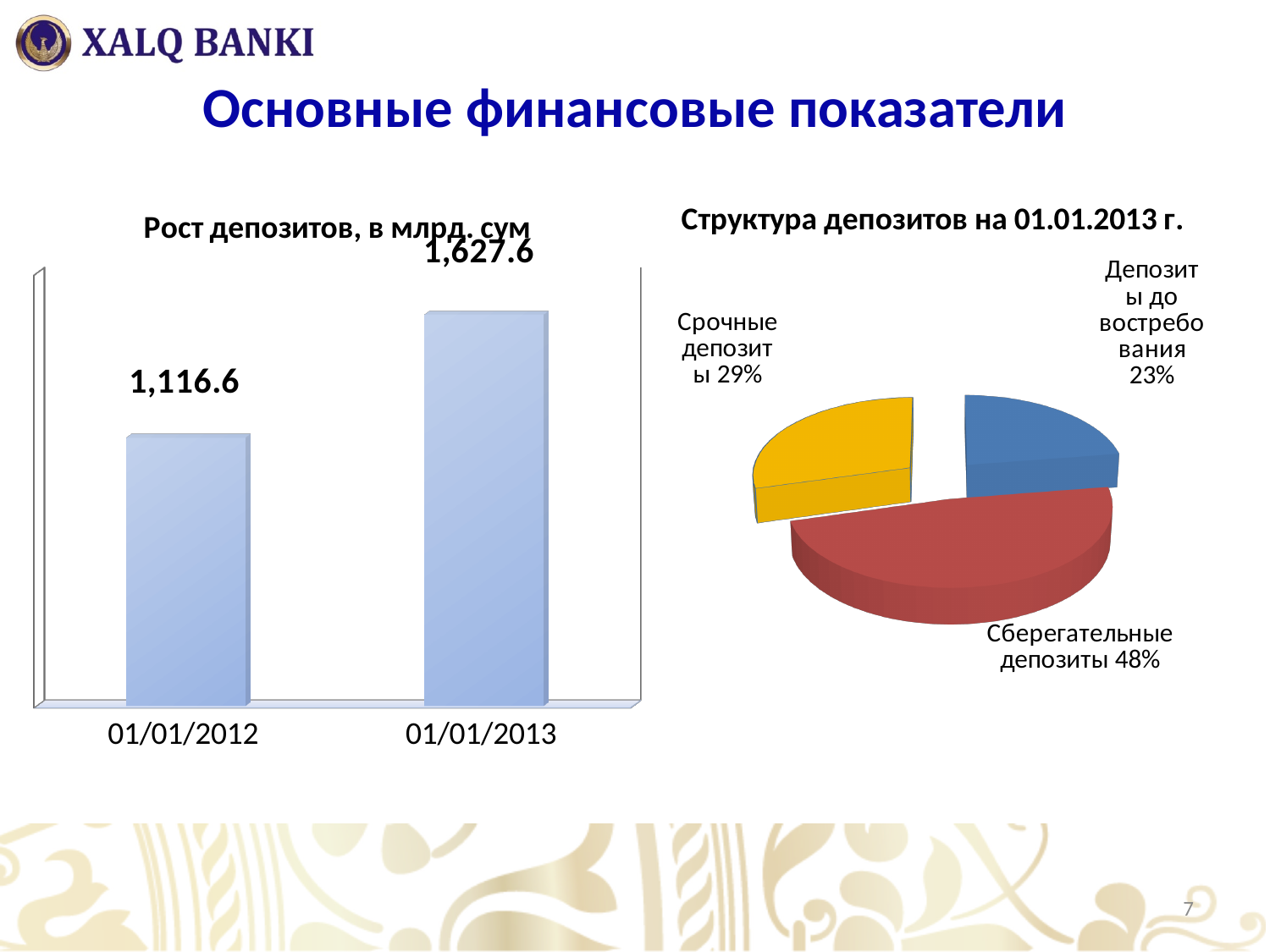
In the chart 'Рост депозитов, в млрд. сум', do the values rise or fall from 01/01/2012 to 01/01/2013? rise In the chart 'Структура депозитов на 01.01.2013 г.', which is larger: Срочные депозиты or Депозиты до востребования? Срочные депозиты In the chart 'Структура депозитов на 01.01.2013 г.', which category has the smallest share? Депозиты до востребования In the chart 'Структура депозитов на 01.01.2013 г.', what share do Срочные депозиты have? 29% What kind of chart is 'Рост депозитов, в млрд. сум'? bar chart How many bars are shown in the chart 'Рост депозитов, в млрд. сум'? 2 In the chart 'Структура депозитов на 01.01.2013 г.', what share do Сберегательные депозиты have? 48% In the chart 'Рост депозитов, в млрд. сум', what is the value for 01/01/2012? 1,116.6 What kind of chart is 'Структура депозитов на 01.01.2013 г.'? pie chart In the chart 'Рост депозитов, в млрд. сум', what is the value for 01/01/2013? 1,627.6 In the chart 'Рост депозитов, в млрд. сум', which date has the higher value? 01/01/2013 In the chart 'Рост депозитов, в млрд. сум', what is the difference between the 01/01/2013 and 01/01/2012 values? 511.0